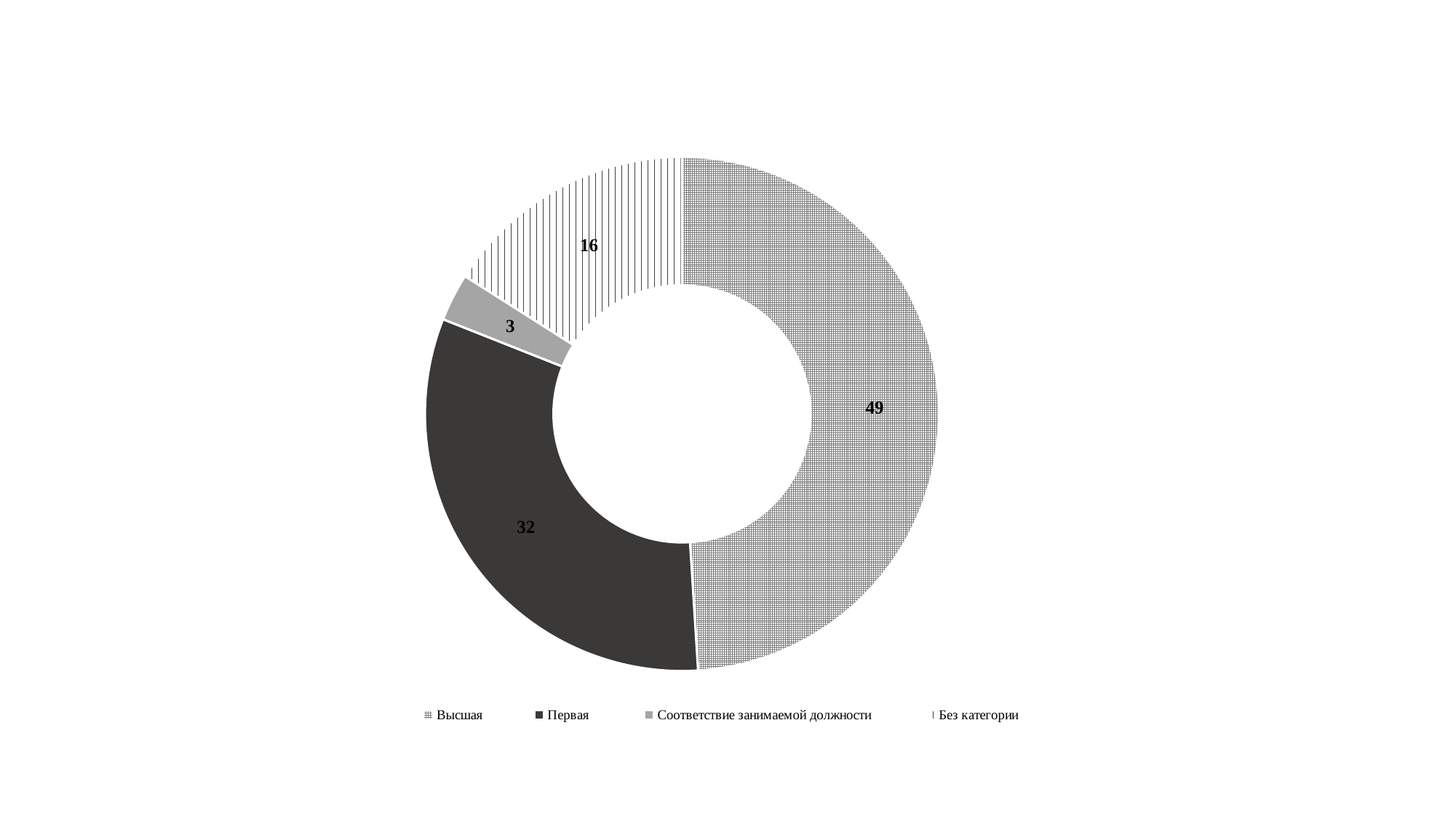
What is the total of all the slices in the chart? 100 How many categories does the chart show? 4 What is the value for Высшая? 49 What is the value for Соответствие занимаемой должности? 3 What type of chart is shown on the slide? doughnut chart What share of the whole does the Без категории slice represent? 16% Which category has the largest slice? Высшая Which category has the smallest slice? Соответствие занимаемой должности Which is larger, the value for Без категории or the value for Первая? Первая What is the value for Первая? 32 What is the value for Без категории? 16 What is the difference between the values for Высшая and Первая? 17